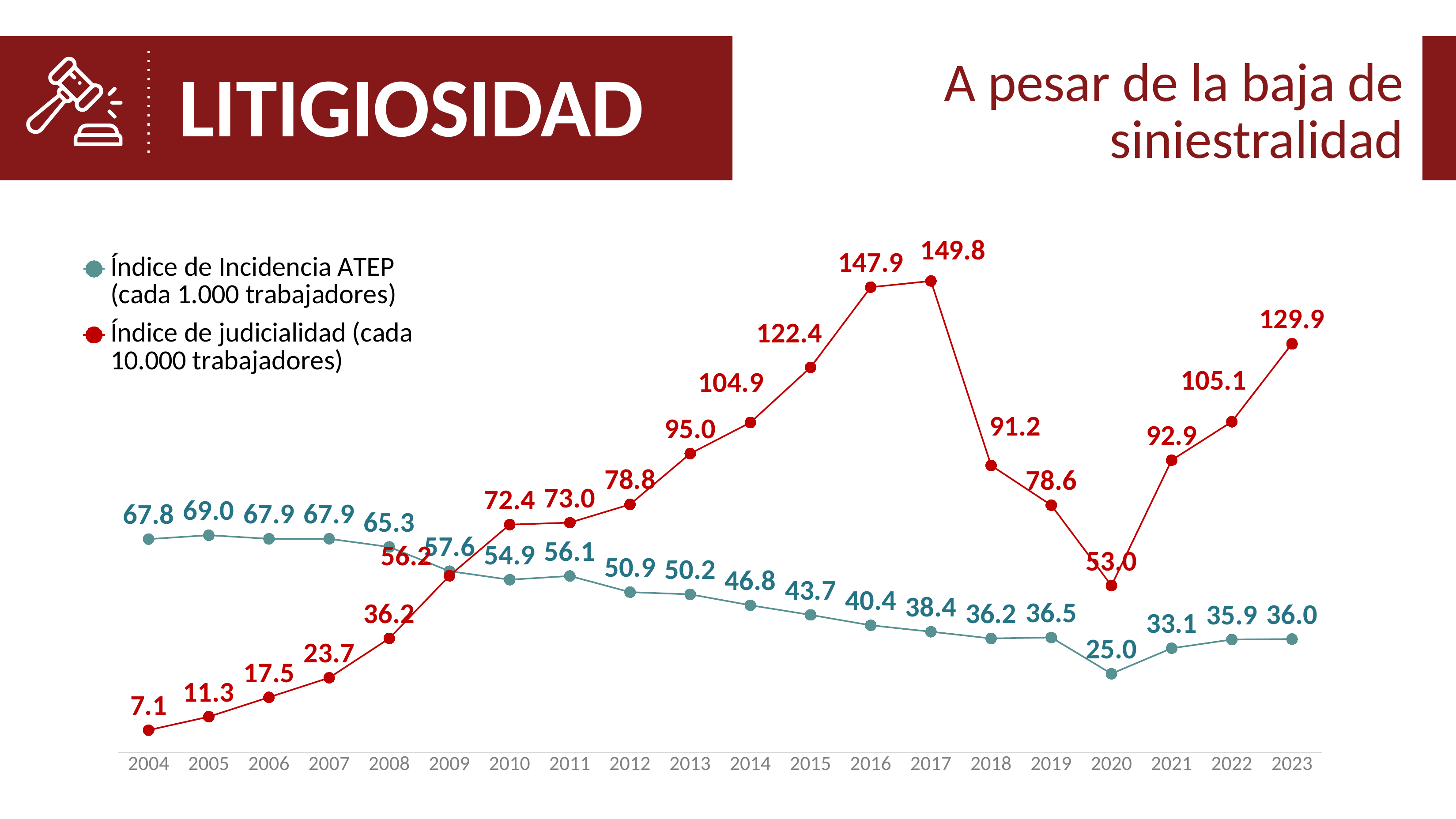
In which year does the Índice de Incidencia ATEP series reach its highest value? 2005 What is the value of the Índice de judicialidad series in 2017? 149.8 How many years are shown on the x axis of the chart? 20 In which year does the Índice de judicialidad series reach its highest value? 2017 In which year does the Índice de Incidencia ATEP series reach its lowest value? 2020 What is the value of the Índice de judicialidad series in 2004? 7.1 What is the difference between the Índice de judicialidad and the Índice de Incidencia ATEP values in 2023? 93.9 Which series has the larger value in 2008, Índice de Incidencia ATEP or Índice de judicialidad? Índice de Incidencia ATEP By how much did the Índice de Incidencia ATEP fall from 2004 to 2023? 31.8 What is the value of the Índice de Incidencia ATEP series in 2020? 25.0 How many series does the legend list? 2 What kind of chart is shown on the slide? Line chart